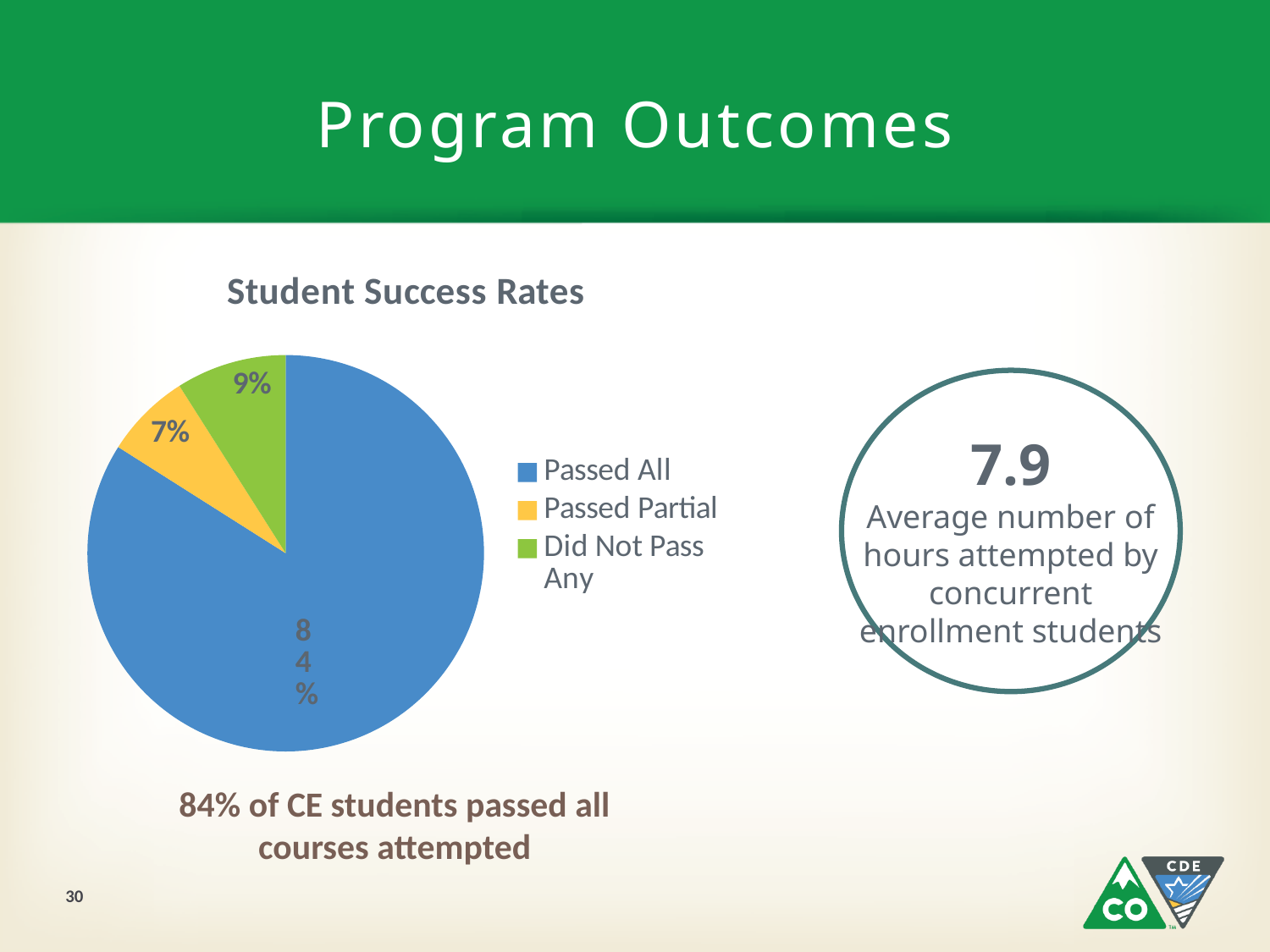
What percentage of students are shown as "Passed All"? 84% Which category has the smallest slice of the pie? Passed Partial Which is larger, the "Did Not Pass Any" slice or the "Passed Partial" slice? Did Not Pass Any What percentage of students are shown as "Passed Partial"? 7% What is the title of the pie chart? Student Success Rates What kind of chart is shown under the title "Student Success Rates"? pie chart How many categories does the pie chart legend list? 3 What is the difference in percentage points between "Passed All" and "Did Not Pass Any"? 75 How many slices does the pie chart have? 3 What percentage of students are shown as "Did Not Pass Any"? 9% What colour is the "Passed Partial" slice in the pie chart? yellow Which category has the largest slice of the pie? Passed All